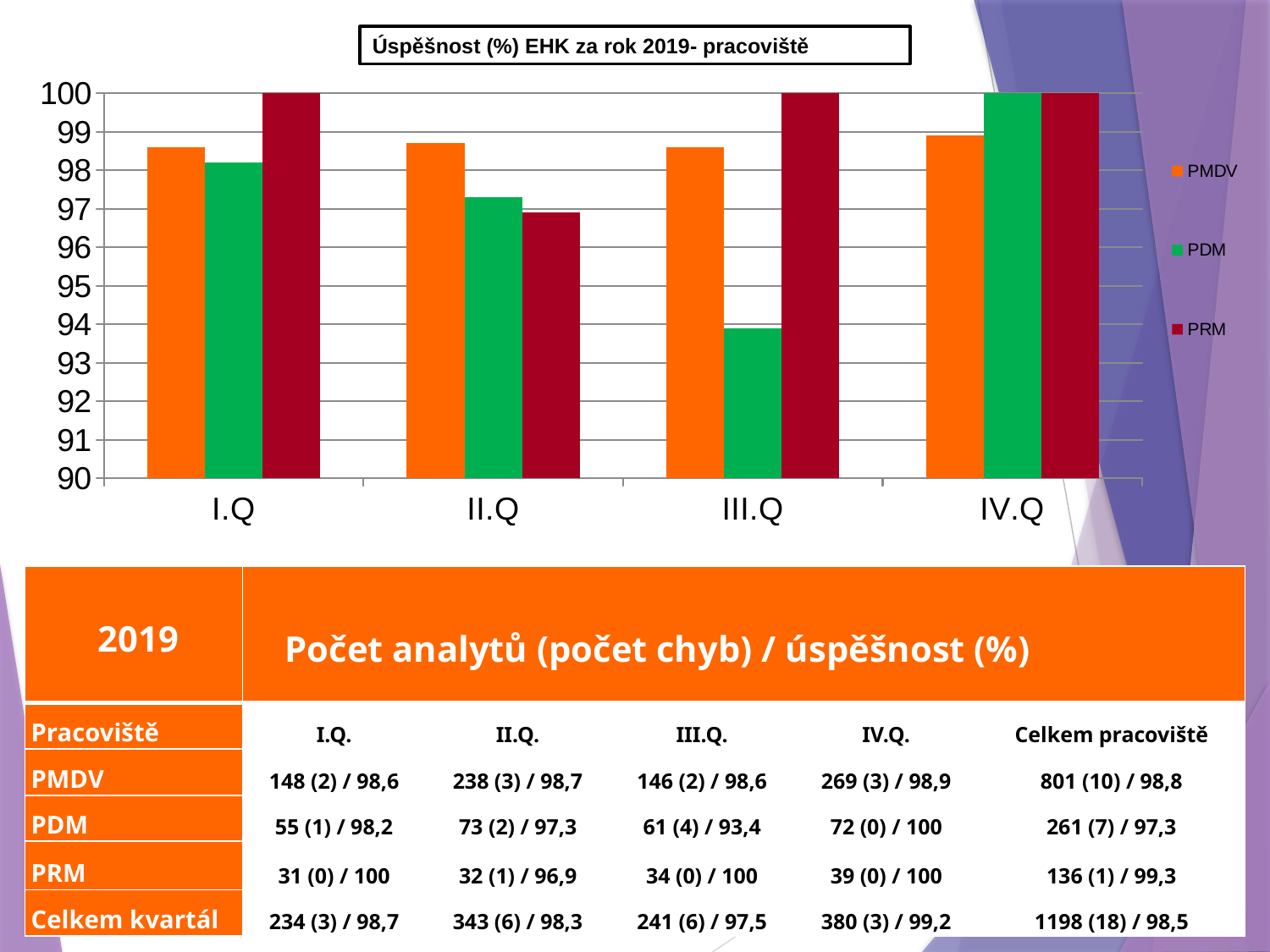
What is the value for PRM in I.Q? 100 Which series has the highest value in III.Q? PRM In I.Q, which is larger, PMDV or PDM? PMDV Which bar is the lowest in the whole chart? PDM in III.Q What kind of chart is shown on the slide? bar chart In II.Q, which is larger, PDM or PRM? PDM Is the value for PDM in III.Q greater or less than 95? less What is the value for PDM in IV.Q? 100 How many series does the chart legend list? 3 Is the value for PRM in II.Q greater or less than 98? less What colour are the PDM bars in the chart? green How many quarters are shown on the x axis of the chart? 4